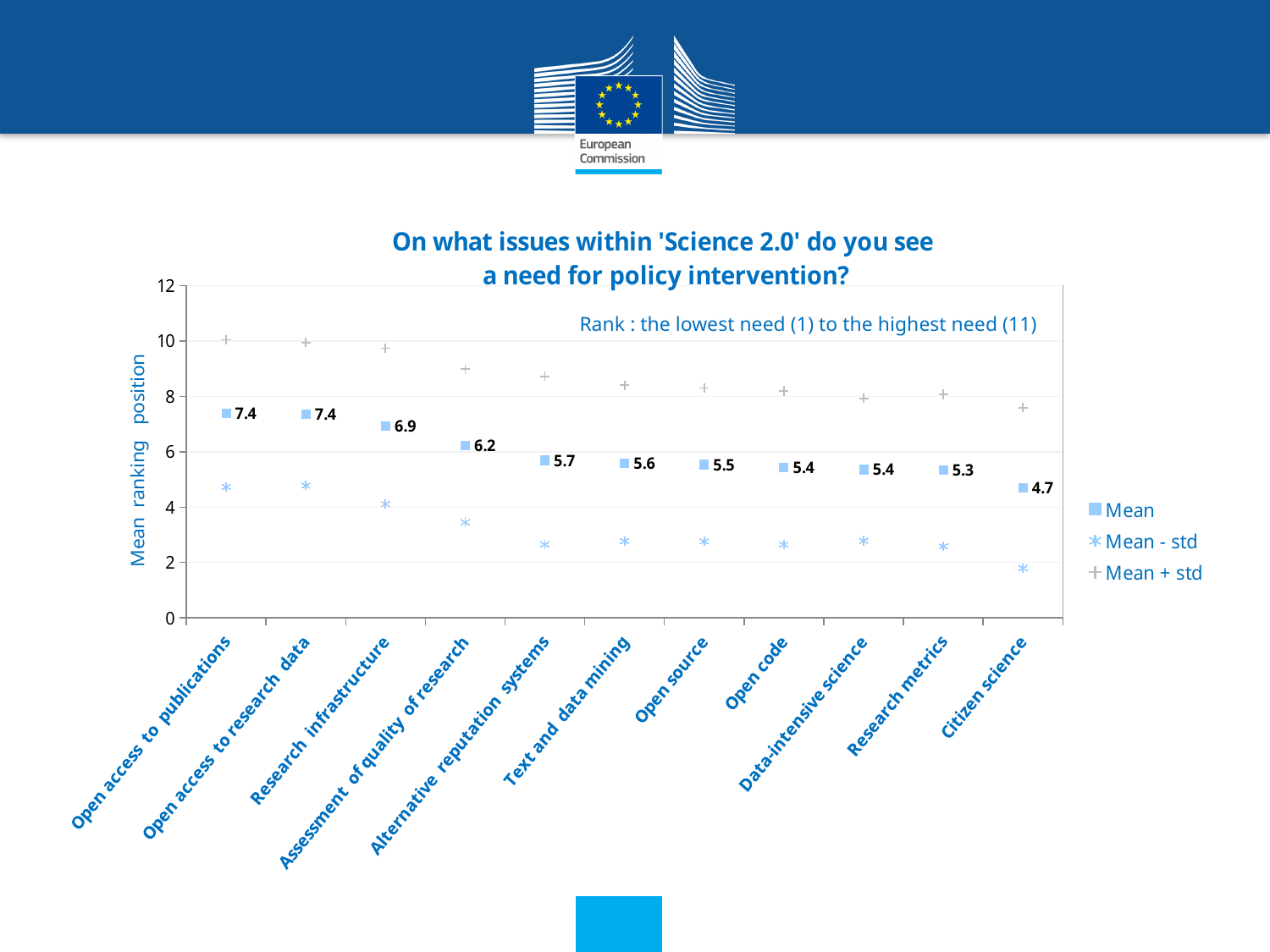
Is the Mean - std value for Open access to publications greater or less than 4? greater Is the Mean + std value for Citizen science greater or less than 8? less What is the Mean value for Text and data mining? 5.6 What is the Mean value for Research infrastructure? 6.9 What is the Mean value for Citizen science? 4.7 What is the Mean value for Open access to publications? 7.4 How many categories are shown on the x axis? 11 Which category has the lowest Mean value? Citizen science Which has a higher Mean value, Research infrastructure or Assessment of quality of research? Research infrastructure How many series does the legend list? 3 What is the difference between the Mean values for Open access to publications and Citizen science? 2.7 Do the Mean values rise or fall from left to right along the x axis? fall